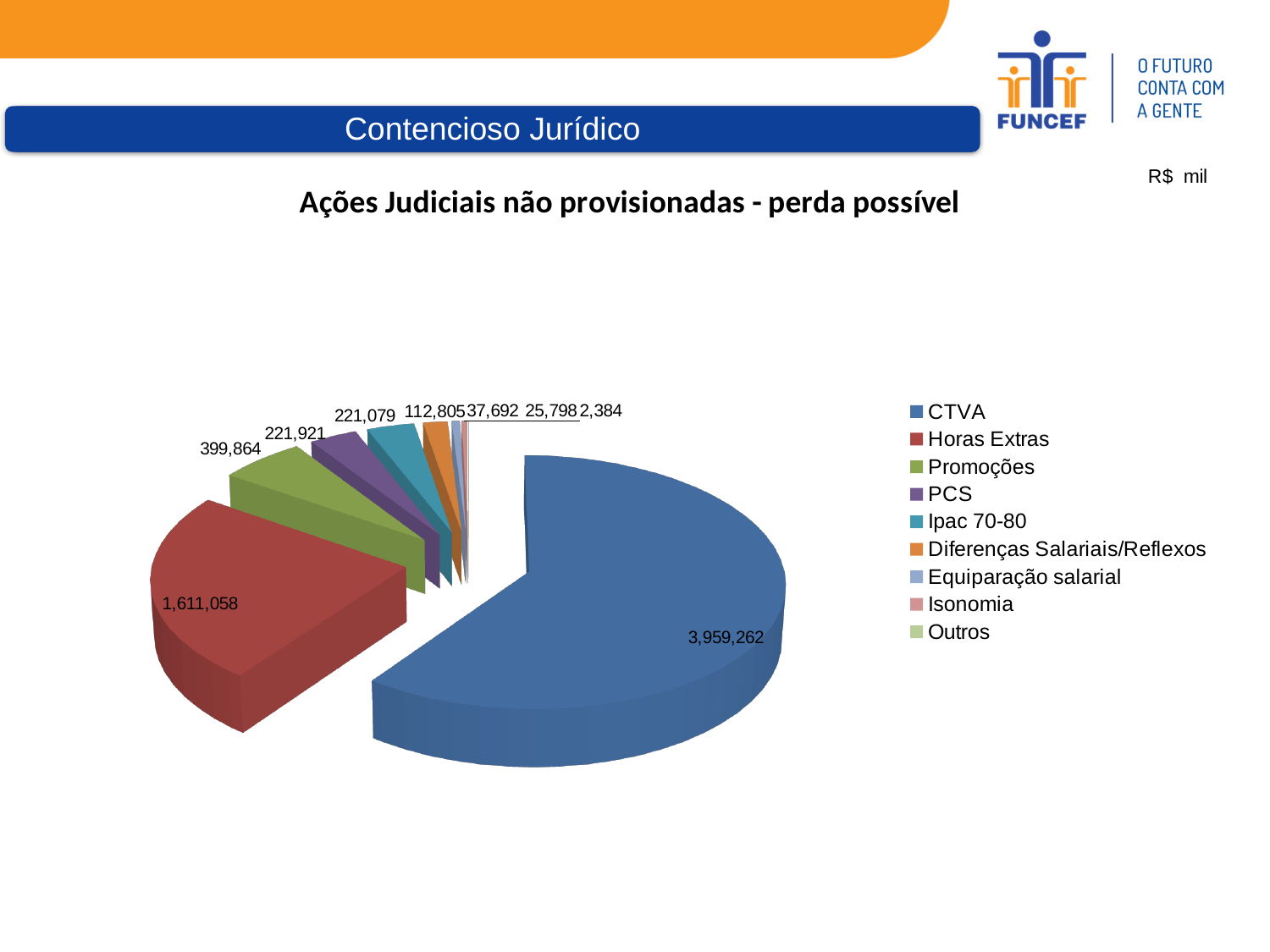
What is the value for Diferenças Salariais/Reflexos? 112,805 Which is larger, the value for Horas Extras or the value for Promoções? Horas Extras What is the value for Horas Extras? 1,611,058 What is the title of the chart? Ações Judiciais não provisionadas - perda possível What is the value for Promoções? 399,864 What type of chart is shown on the slide? Pie chart Which category has the smallest value? Outros How many categories does the pie chart have? 9 What is the difference between the values for CTVA and Horas Extras? 2,348,204 What is the value for CTVA? 3,959,262 Which category has the largest slice of the pie? CTVA What is the difference between the values for Promoções and PCS? 177,943